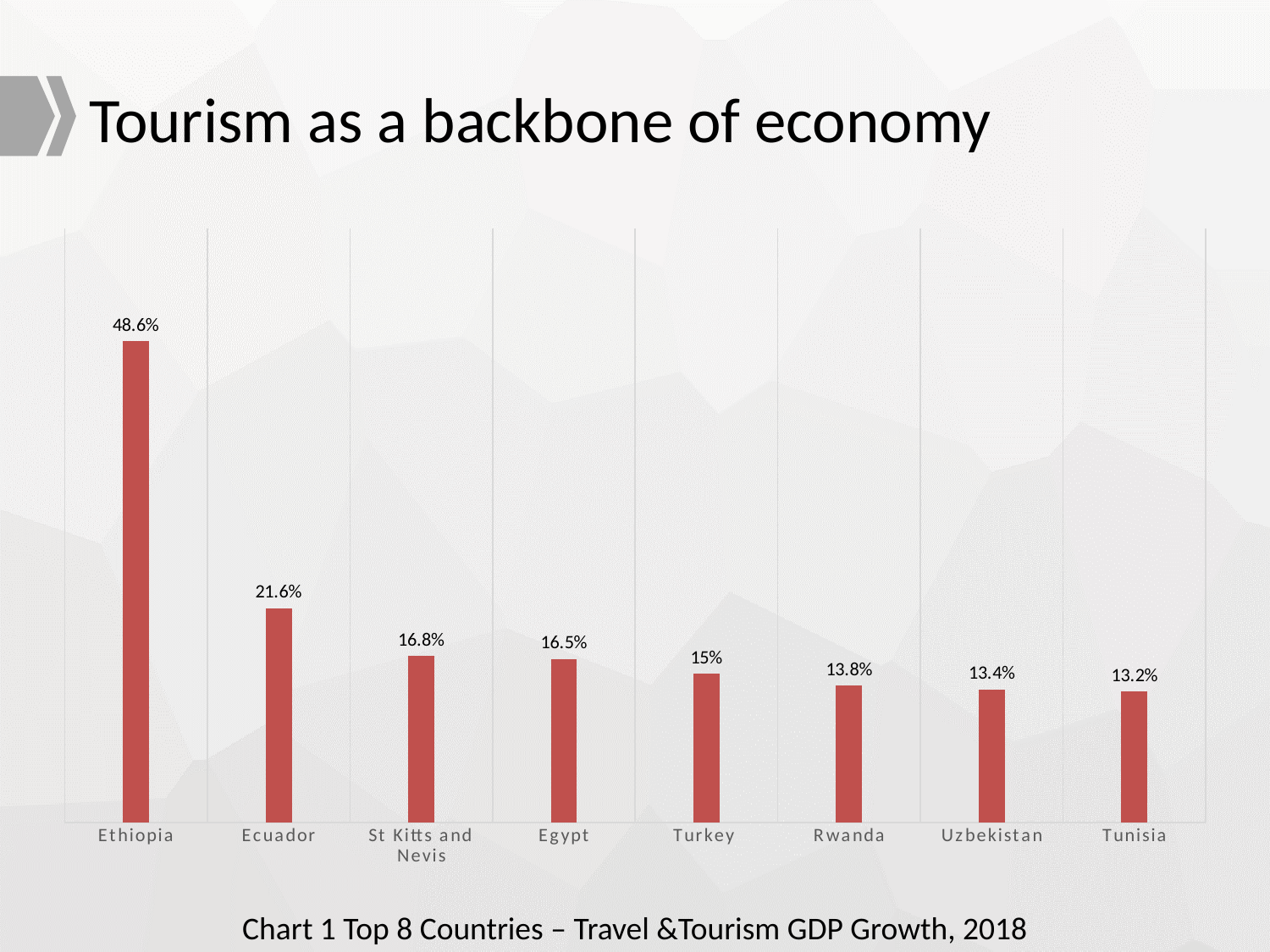
What is the difference between the values for Rwanda and Tunisia? 0.6 percentage points What value is shown for Turkey? 15% What is the caption given below the chart? Chart 1 Top 8 Countries – Travel &Tourism GDP Growth, 2018 What type of chart is shown on the slide? Bar chart What value is shown for St Kitts and Nevis? 16.8% Which country has the lowest value in the chart? Tunisia Do the values rise or fall moving from left to right across the countries? Fall What is the difference between the values for Ethiopia and Ecuador? 27 percentage points Which has a larger value, Egypt or Uzbekistan? Egypt What is the Travel & Tourism GDP growth value shown for Ethiopia? 48.6% How many countries are shown in the chart? 8 Which country has the highest value in the chart? Ethiopia